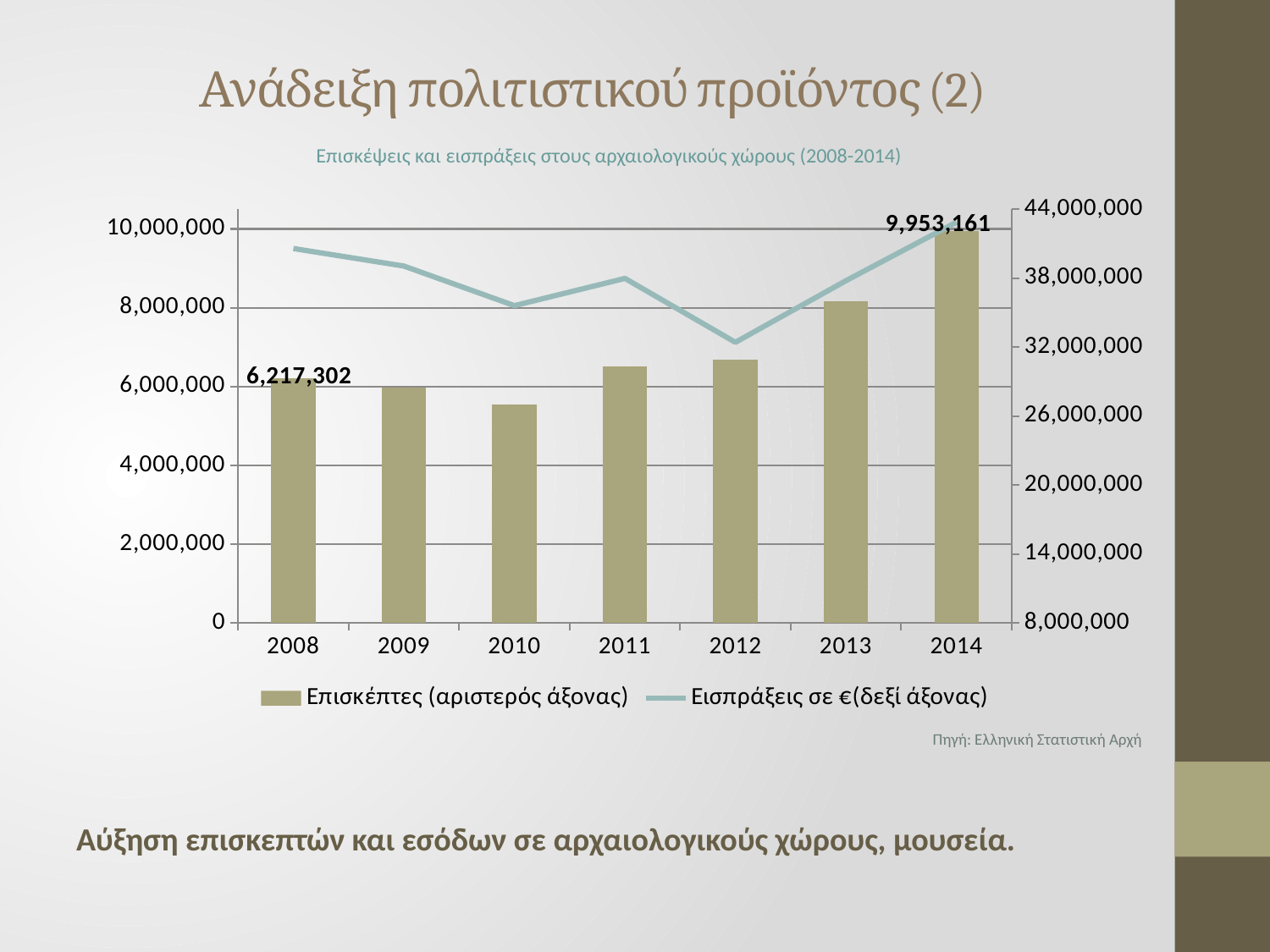
Which year has more visitors, 2012 or 2013? 2013 In which year is the number of visitors (bars) highest? 2014 How many years are shown on the x axis of the chart? 7 What is the number of visitors (Επισκέπτες) shown for 2008? 6,217,302 In which year are the receipts (Εισπράξεις, line) lowest? 2012 What is the number of visitors (Επισκέπτες) shown for 2014? 9,953,161 In which year is the number of visitors (bars) lowest? 2010 What kind of chart is shown on the slide? A bar chart combined with a line chart Is the number of visitors in 2010 greater or less than 6,000,000? less Is the number of visitors in 2013 greater or less than 8,000,000? greater How many series does the chart legend list? 2 By how much did the number of visitors in 2014 exceed the number in 2008? 3,735,859